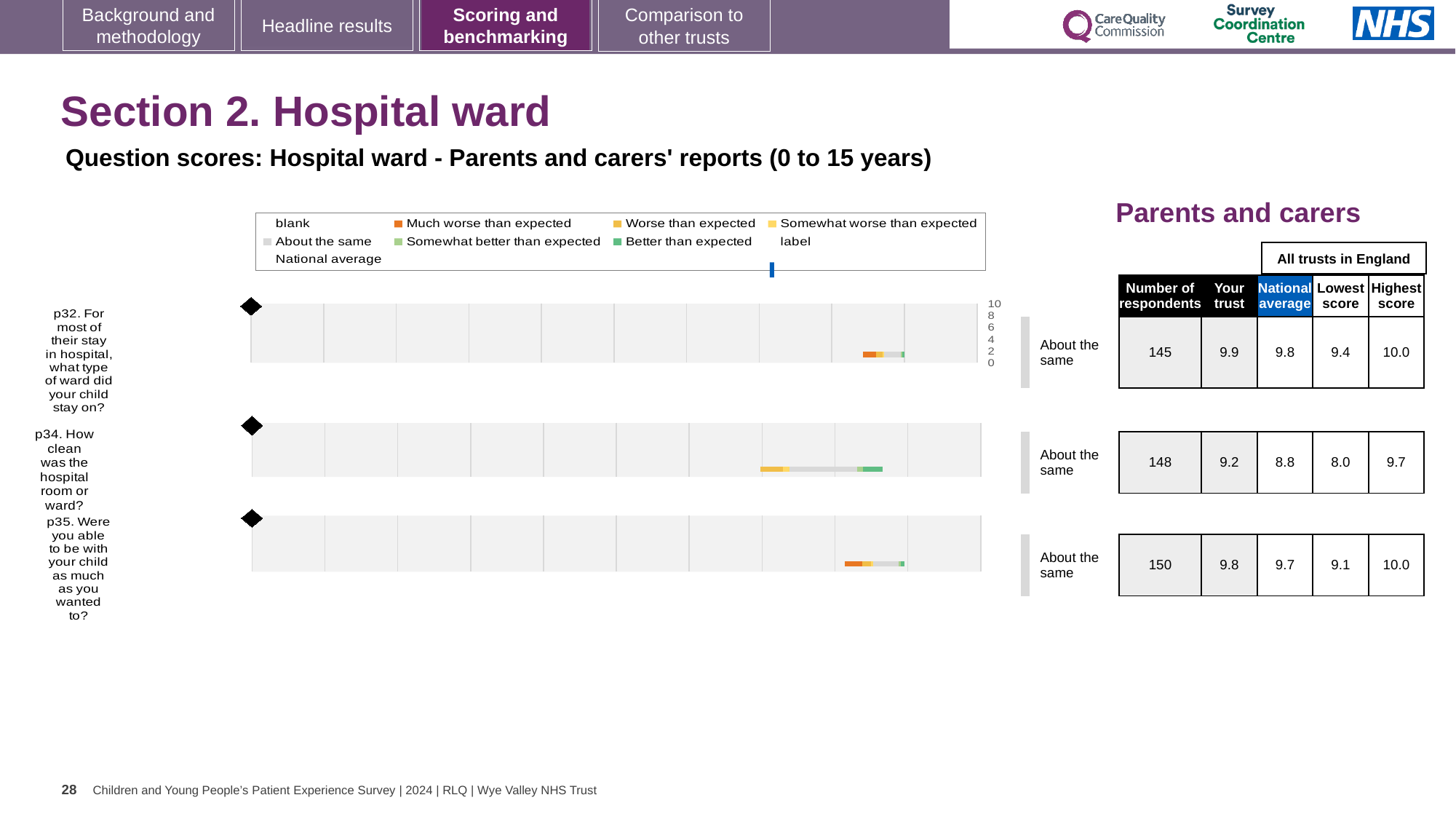
What kind of chart is used to show the question scores on this slide? Bar chart For p34, what is the difference between the 'Your trust' score and the national average? 0.4 How many respondents answered p35 (were you able to be with your child as much as you wanted to)? 150 What is the national average score for p34 (how clean was the hospital room or ward)? 8.8 How many questions (p32, p34, p35) are plotted on the slide? 3 What is the 'Your trust' score for p32 (what type of ward did your child stay on)? 9.9 Which question has the lowest national average score? p34 Which colour in the legend represents 'Much worse than expected'? Orange For p35, which is larger: the 'Your trust' score or the national average? Your trust What benchmark category is shown for p34? About the same What is the highest score among all trusts in England for p34? 9.7 Which question has the highest 'Your trust' score? p32